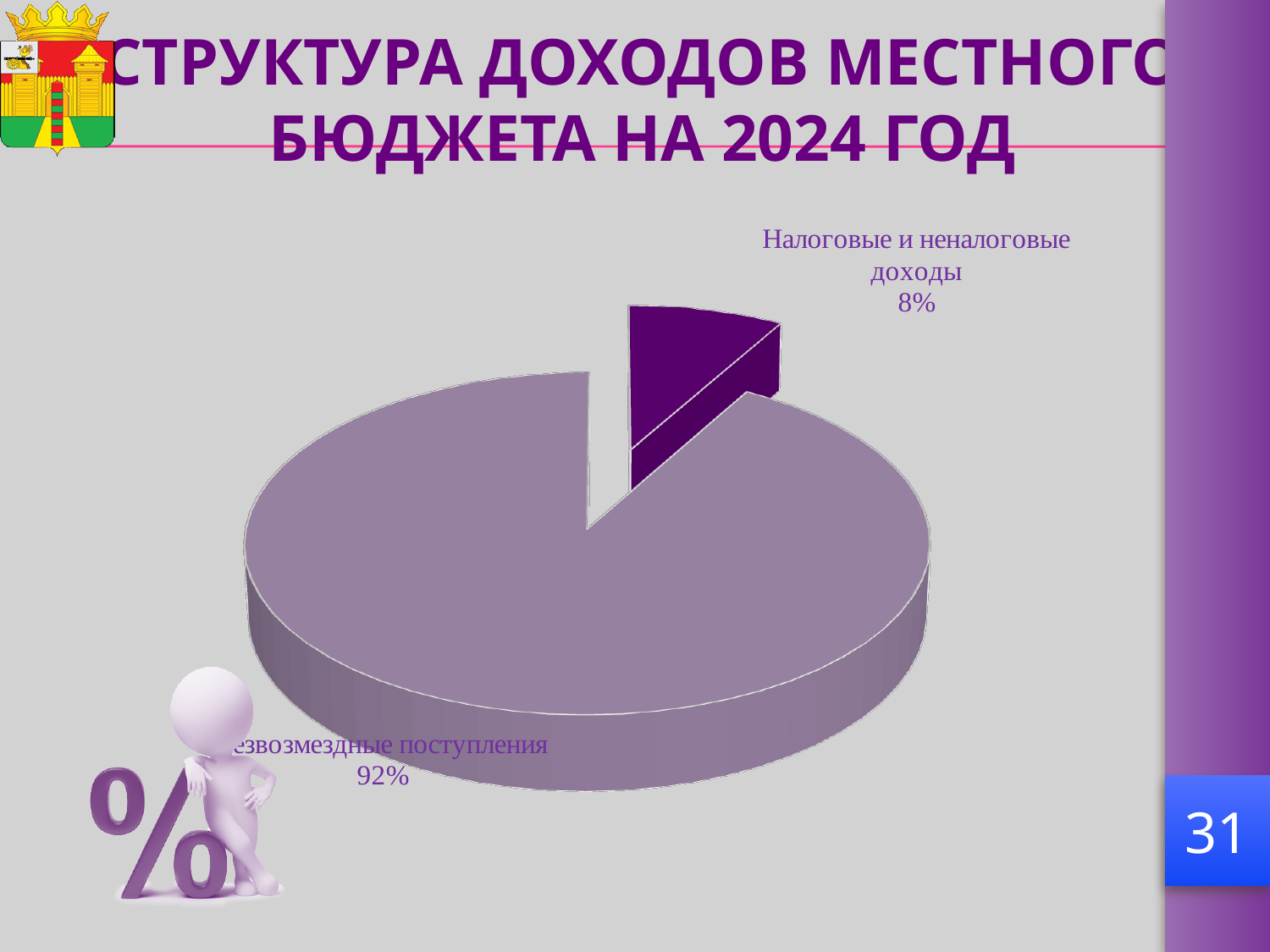
How many slices does the pie chart have? 2 Which slice of the pie is the smallest? Налоговые и неналоговые доходы What is the difference in percentage points between "Безвозмездные поступления" and "Налоговые и неналоговые доходы"? 84 percentage points What share of the pie does "Безвозмездные поступления" take? 92% What kind of chart is shown on the slide? Pie chart What is the title of the slide containing the pie chart? СТРУКТУРА ДОХОДОВ МЕСТНОГО БЮДЖЕТА НА 2024 ГОД Which slice of the pie is the largest? Безвозмездные поступления Which is larger: "Налоговые и неналоговые доходы" or "Безвозмездные поступления"? Безвозмездные поступления Which slice of the pie is shown in dark purple and pulled out from the rest? Налоговые и неналоговые доходы What share of the pie does "Налоговые и неналоговые доходы" take? 8% What year does the budget revenue structure in the chart refer to? 2024